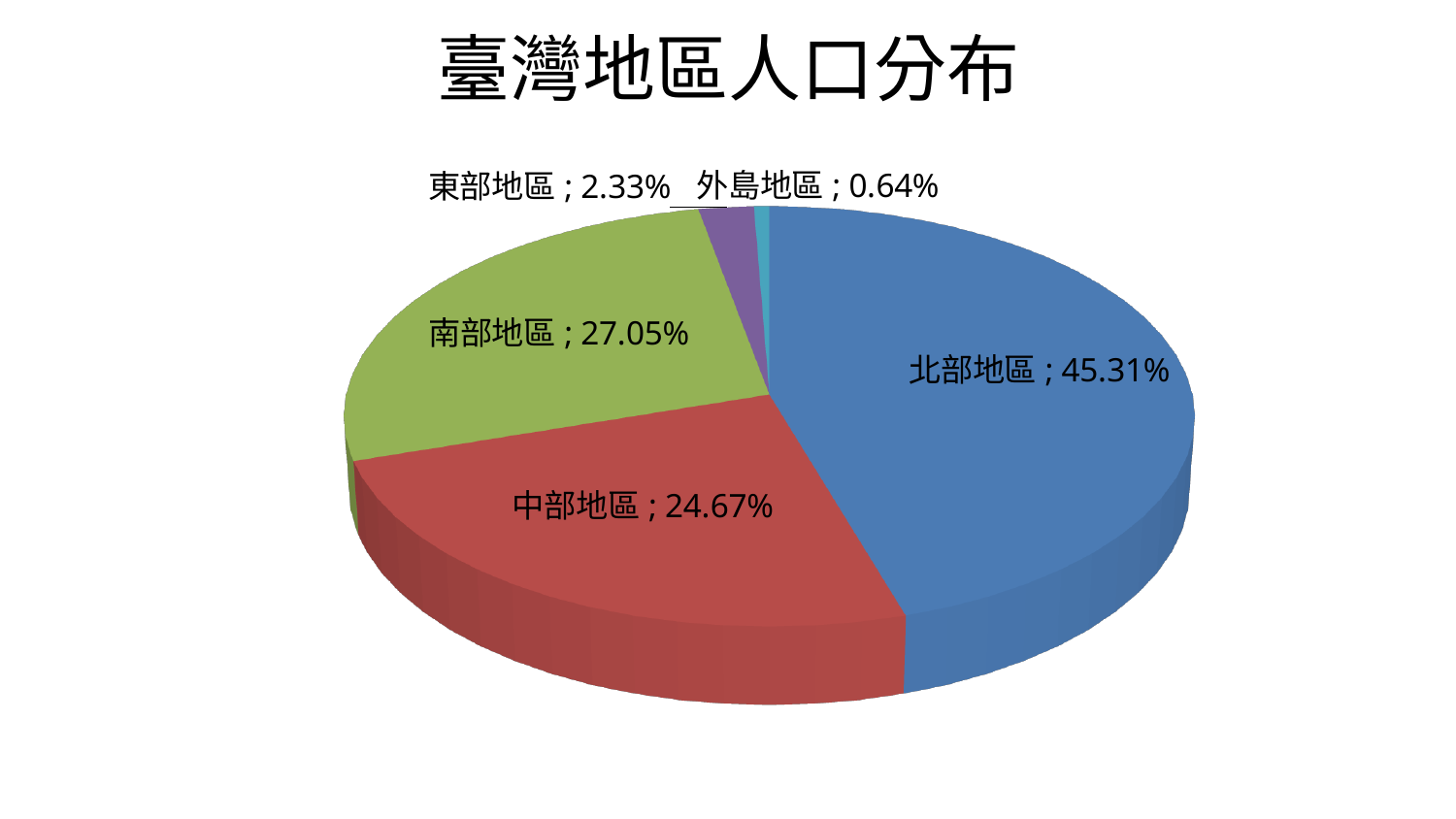
Which region has the largest share of the pie? 北部地區 What is the share for 東部地區? 2.33% What is the difference between the shares of 北部地區 and 南部地區? 18.26% What is the share for 中部地區? 24.67% Which region has the smallest share of the pie? 外島地區 What is the share for 北部地區? 45.31% What is the share for 外島地區? 0.64% Which has a larger share, 南部地區 or 中部地區? 南部地區 What is the title of the chart? 臺灣地區人口分布 What is the share for 南部地區? 27.05% How many regions are shown in the pie chart? 5 What kind of chart is shown on the slide? Pie chart